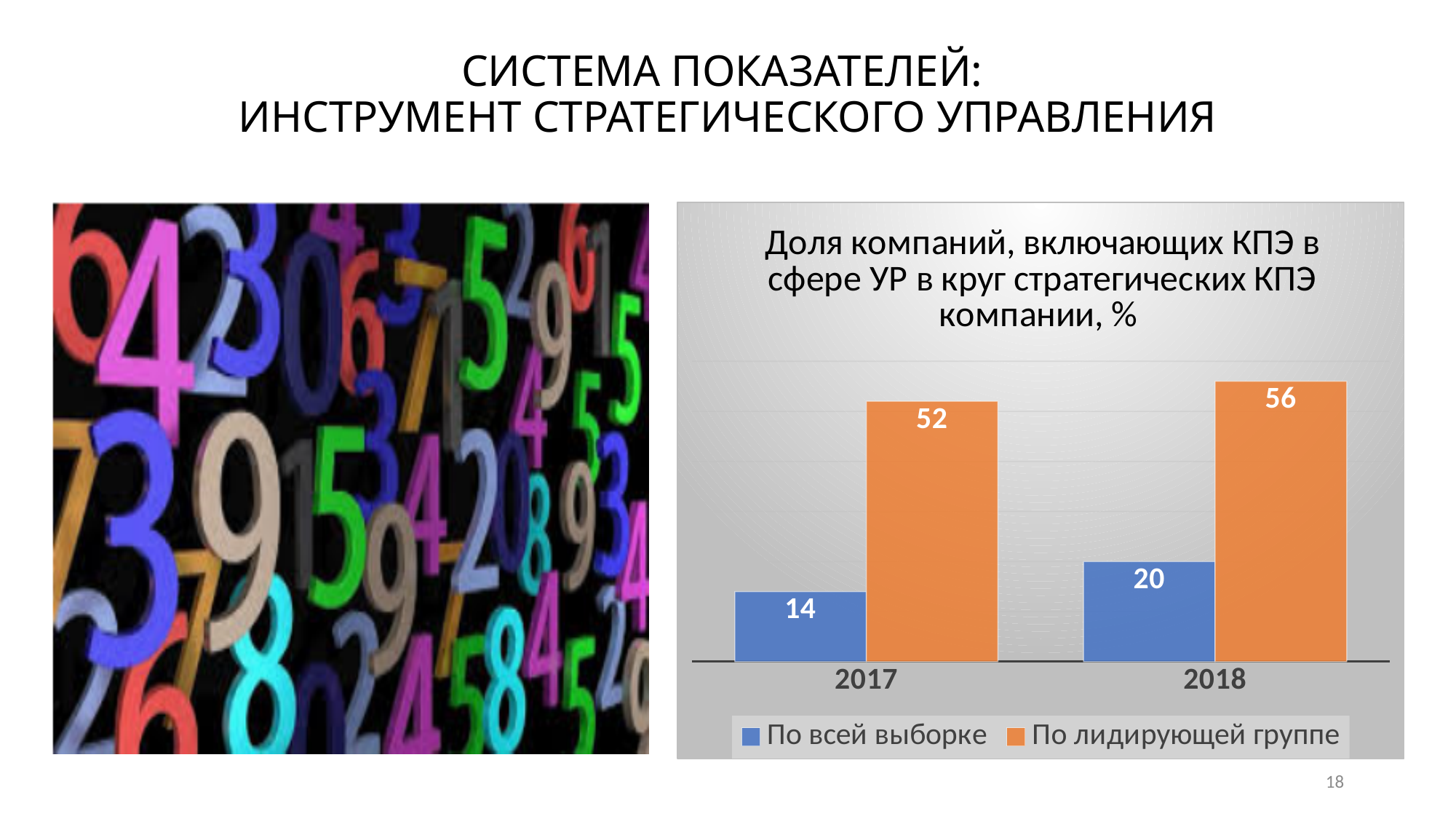
Which year has the lowest value for "По всей выборке"? 2017 What is the value for "По лидирующей группе" in 2018? 56 How many series does the legend list? 2 What kind of chart is shown on the slide? Bar chart Which is larger in 2017: "По всей выборке" or "По лидирующей группе"? По лидирующей группе Do the values for "По лидирующей группе" rise or fall from 2017 to 2018? Rise What is the difference between "По лидирующей группе" and "По всей выборке" in 2018? 36 What is the value for "По всей выборке" in 2018? 20 By how much did the value for "По всей выборке" change from 2017 to 2018? 6 What is the value for "По лидирующей группе" in 2017? 52 What is the value for "По всей выборке" in 2017? 14 Which year has the highest value for "По лидирующей группе"? 2018